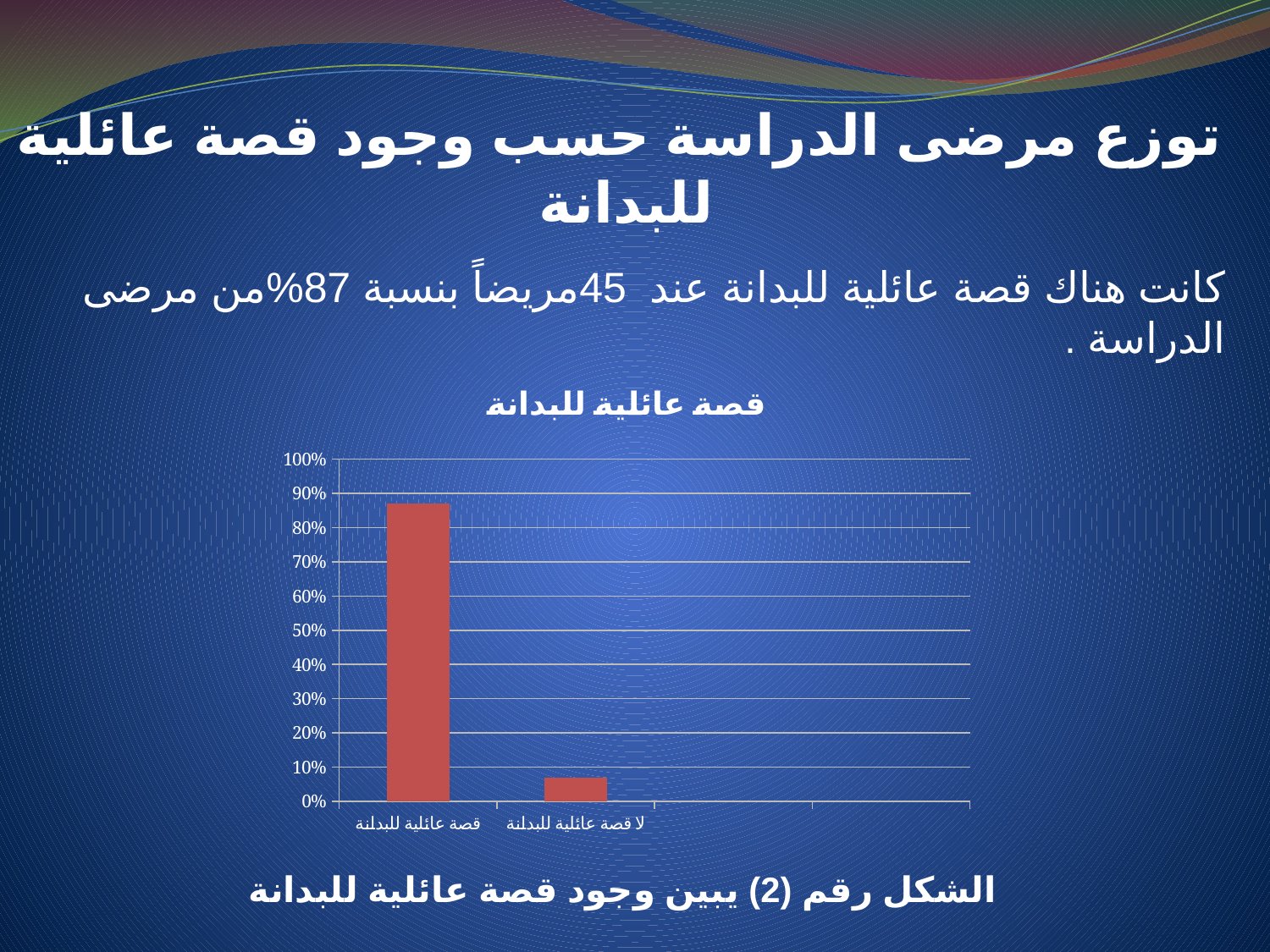
What is the title of the chart? قصة عائلية للبدانة How many categories are plotted in the chart? 2 What is the highest tick value shown on the vertical axis of the chart? 100% Is the value for قصة عائلية للبدانة greater or less than 90%? less What kind of chart is shown on the slide? bar chart Which category has the highest bar in the chart? قصة عائلية للبدانة Which is larger, the bar for قصة عائلية للبدانة or the bar for لا قصة عائلية للبدانة? قصة عائلية للبدانة Is the value for لا قصة عائلية للبدانة greater or less than 50%? less Is the value for لا قصة عائلية للبدانة greater or less than 10%? less Which category has the lowest bar in the chart? لا قصة عائلية للبدانة